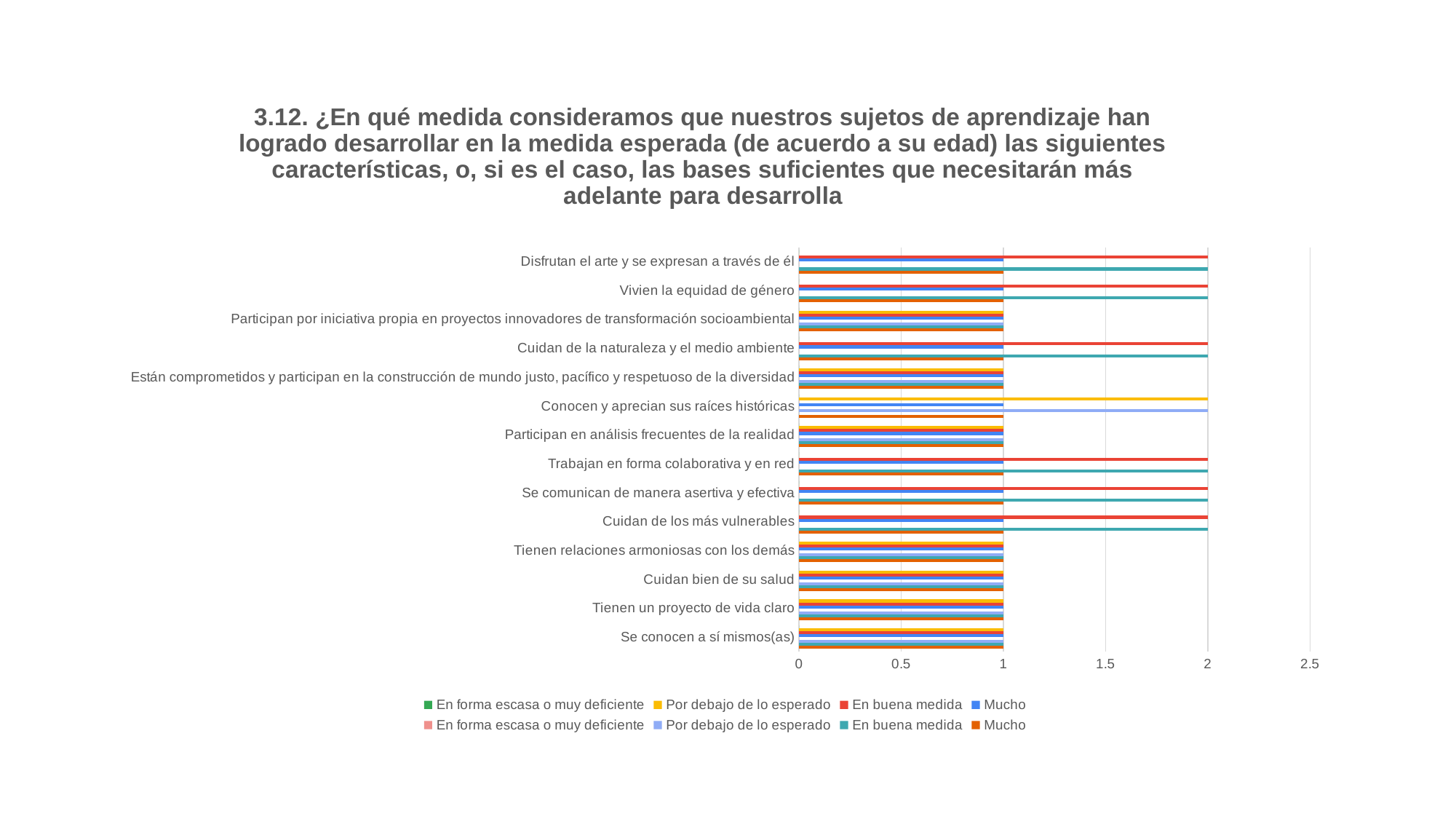
How many categories (characteristics) are listed on the vertical axis of the chart? 14 What kind of chart is shown on the slide? Bar chart What value does the yellow "Por debajo de lo esperado" bar for "Conocen y aprecian sus raíces históricas" reach? 2 What value does the red "En buena medida" bar for "Cuidan de la naturaleza y el medio ambiente" reach? 2 Is the longest bar for "Tienen un proyecto de vida claro" greater or less than 1.5? less Is the longest bar for "Cuidan de los más vulnerables" greater or less than 1.5? greater What is the highest value shown on the horizontal axis of the chart? 2.5 Which category has a longer longest bar: "Vivien la equidad de género" or "Cuidan bien de su salud"? Vivien la equidad de género What value does the longest bar for "Disfrutan el arte y se expresan a través de él" reach? 2 What value does the longest bar for "Se conocen a sí mismos(as)" reach? 1 How many series entries does the chart legend list? 8 Which category is listed at the top of the chart? Disfrutan el arte y se expresan a través de él